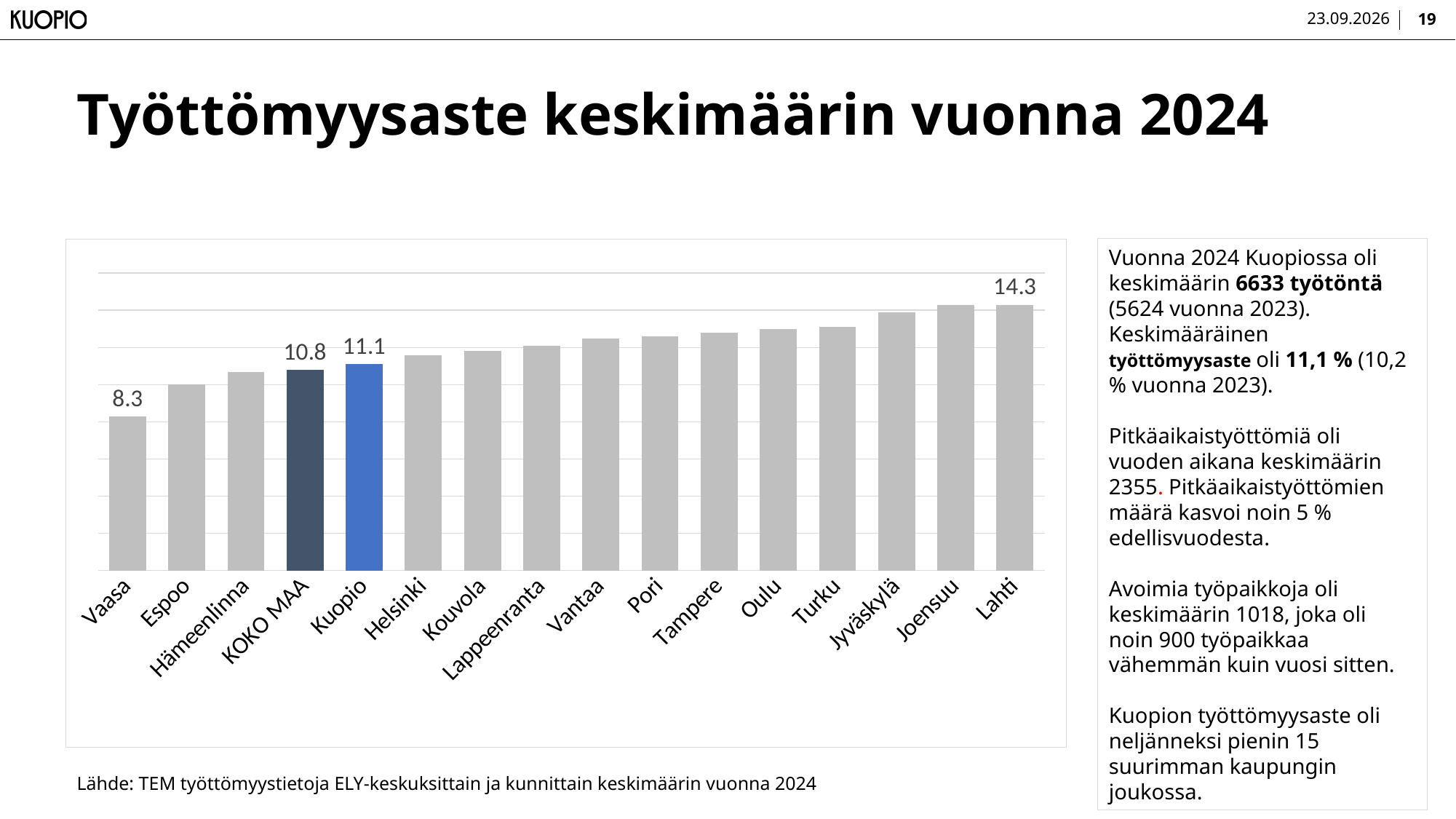
How many categories are shown on the x axis? 16 What is the value for Kuopio? 11.1 What is the value for Lahti? 14.3 What is the difference between the values for Lahti and Vaasa? 6.0 What is the value for KOKO MAA? 10.8 What kind of chart is shown on the slide? Bar chart Do the values rise or fall from left to right along the x axis? Rise What is the difference between the values for Kuopio and KOKO MAA? 0.3 Which is larger, the value for Helsinki or the value for Espoo? Helsinki Which category has the lowest value? Vaasa What is the value for Vaasa? 8.3 Which category has the highest value? Joensuu and Lahti (tied at 14.3)